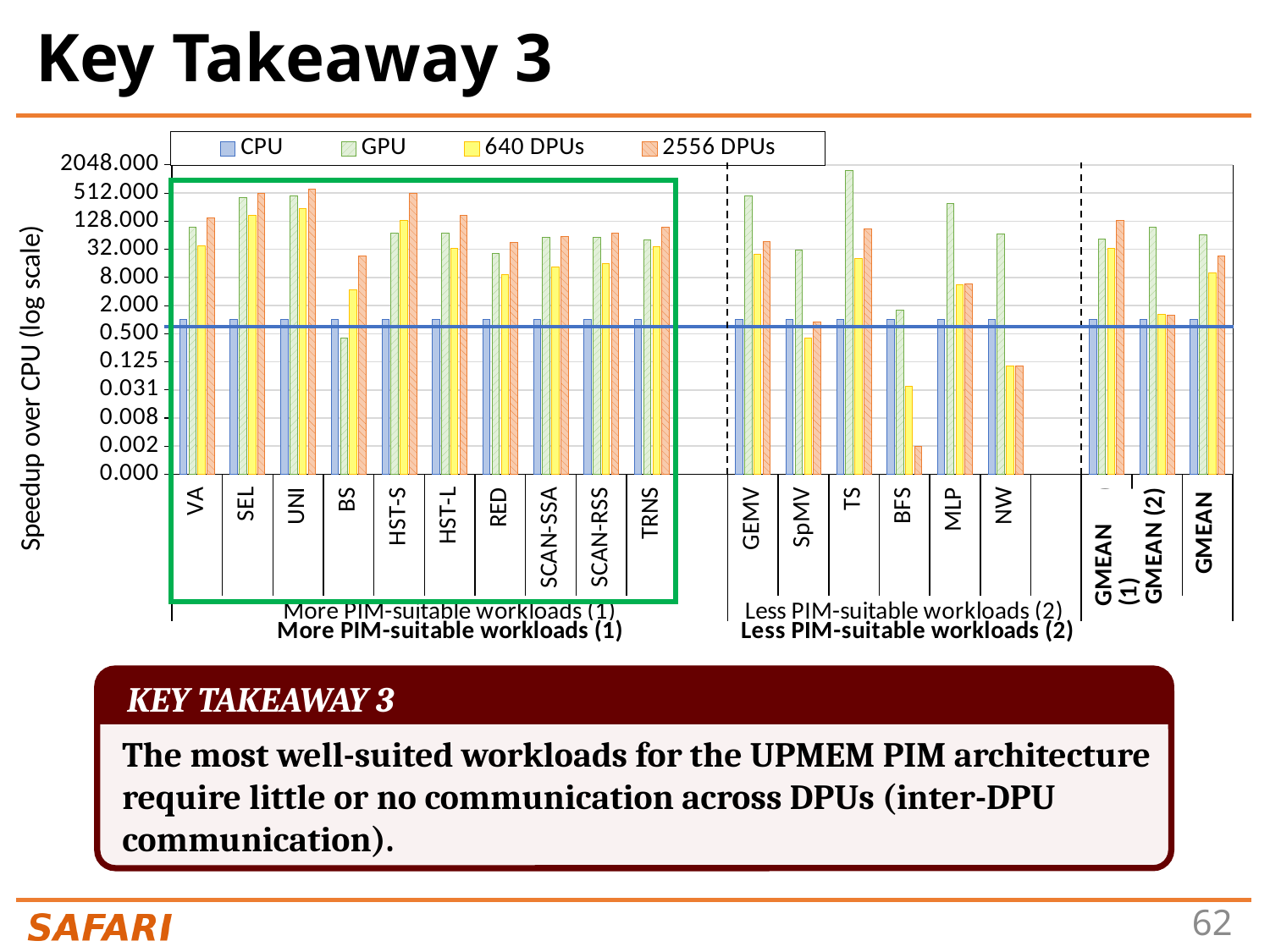
What is the label of the y axis? Speedup over CPU (log scale) What kind of chart is shown on the slide? bar chart Is the 2556 DPUs value for BFS greater or less than 0.031? less How many workloads are in the 'More PIM-suitable workloads (1)' group? 10 Which workload has the lowest 2556 DPUs speedup? BFS How many series does the legend list? 4 Is the 640 DPUs value for NW greater or less than 0.500? less For BS, which is larger: the GPU value or the 2556 DPUs value? 2556 DPUs Which workload has the highest GPU speedup? TS What are the series listed in the legend? CPU, GPU, 640 DPUs, 2556 DPUs How many workloads are in the 'Less PIM-suitable workloads (2)' group? 6 Is the GPU value for TS greater or less than 512.000? greater